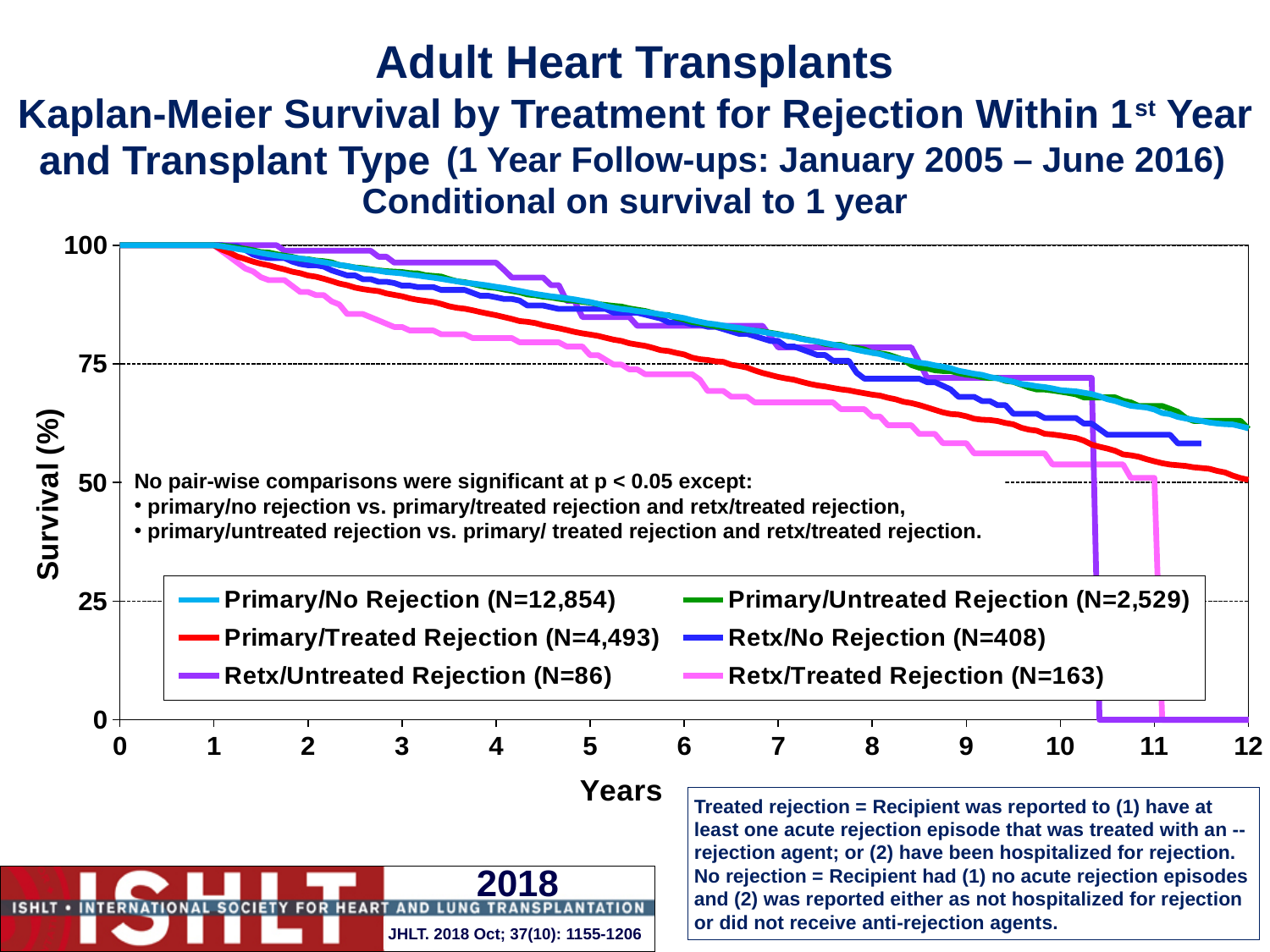
Which group in the legend has the largest N? Primary/No Rejection Is the survival value for Primary/No Rejection at 12 years greater or less than 50? greater What kind of chart is shown on the slide? Line chart At 4 years, which has higher survival: Primary/No Rejection or Primary/Treated Rejection? Primary/No Rejection How many series does the legend list? 6 What is the N for the Primary/No Rejection group shown in the legend? N=12,854 Is the survival value for Retx/Untreated Rejection at 11 years greater or less than 25? less Is the survival value for Retx/Treated Rejection at 8 years greater or less than 75? less Do the survival curves rise or fall as years increase? Fall What is the label of the y axis? Survival (%) Which group in the legend has the smallest N? Retx/Untreated Rejection What is the N for the Retx/Untreated Rejection group shown in the legend? N=86